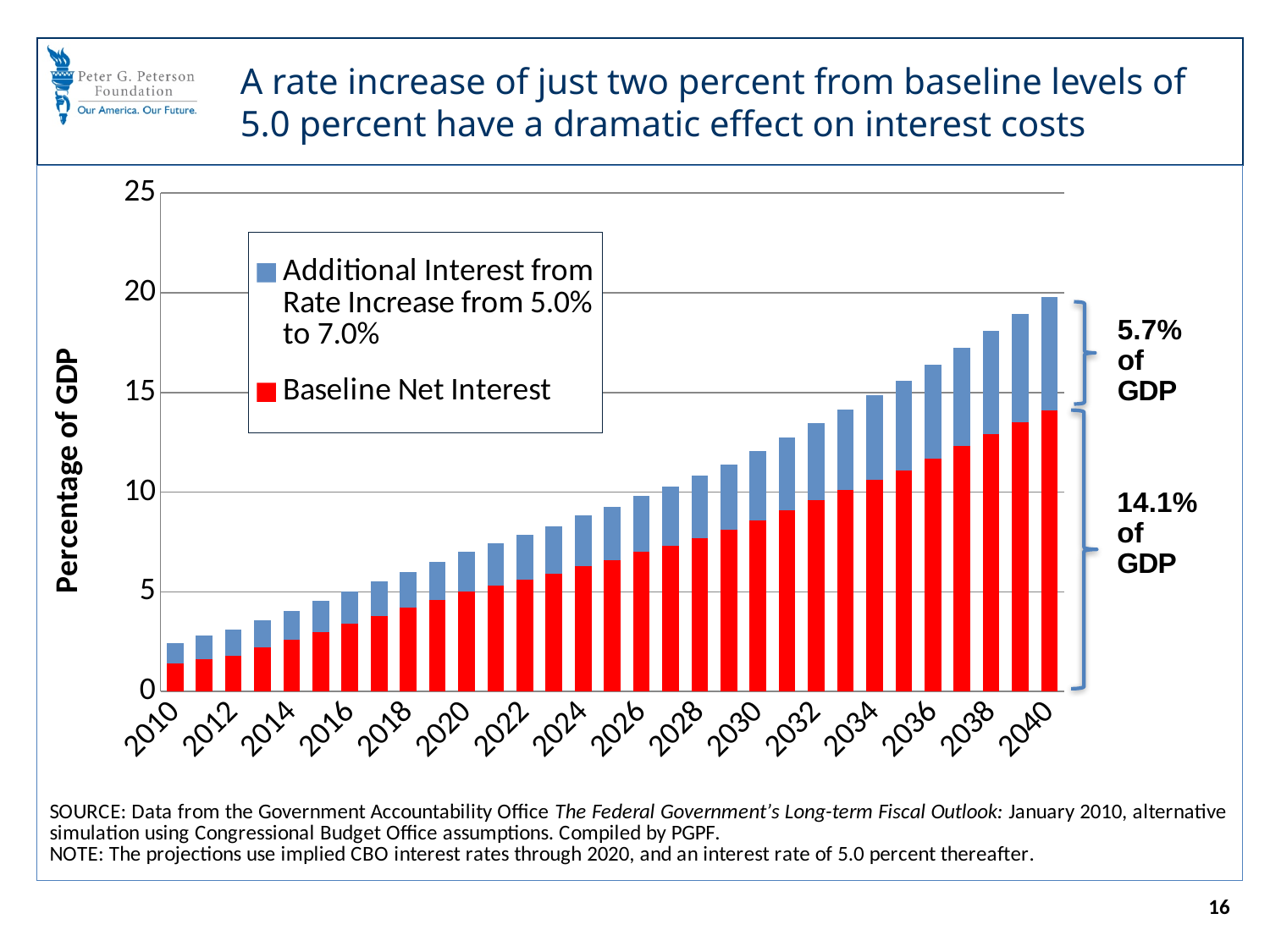
In 2040, which is larger: Baseline Net Interest or the Additional Interest from the rate increase? Baseline Net Interest What is the label on the vertical axis? Percentage of GDP What are the two series named in the legend? Additional Interest from Rate Increase from 5.0% to 7.0%; Baseline Net Interest What is the Additional Interest from the rate increase in 2040, as annotated on the chart? 5.7% of GDP Which year has the highest total interest cost as a percentage of GDP? 2040 How many series does the legend list? 2 Is the total stacked value for 2010 greater or less than 5? less Which year has the lowest total interest cost as a percentage of GDP? 2010 What is the Baseline Net Interest value in 2040, as annotated on the chart? 14.1% of GDP Do the total interest costs rise or fall from 2010 to 2040? rise What is the total height of the stacked bar for 2040 (baseline plus additional interest)? 19.8% of GDP What kind of chart is shown on the slide? Stacked bar chart